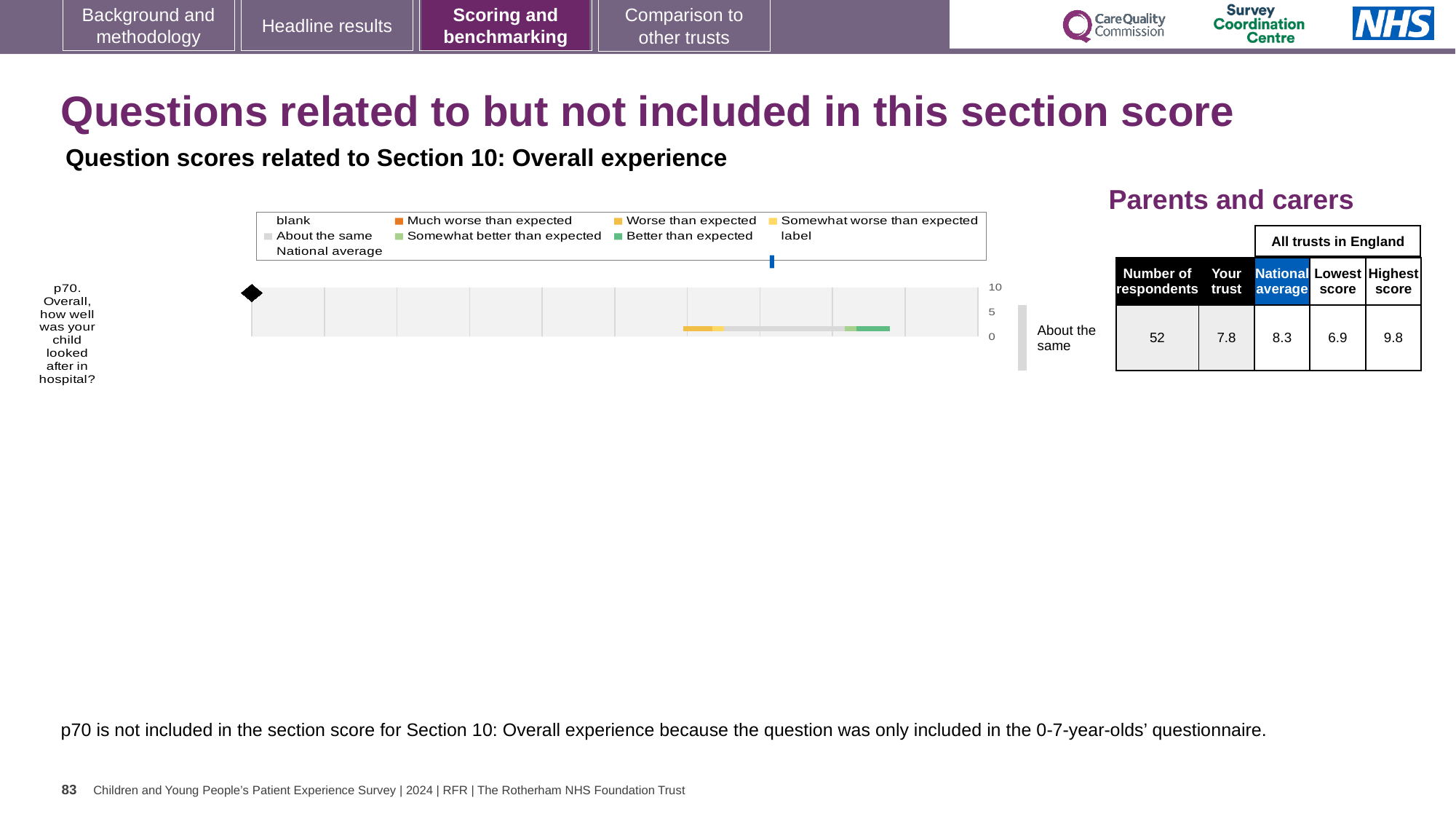
What is the national average score for p70 shown in the table? 8.3 What is the 'Your trust' score for p70 shown in the table? 7.8 How many respondents answered p70 for this trust? 52 What is the difference between the highest and lowest scores among all trusts in England for p70? 2.9 According to the label next to the chart, how does the trust's result for p70 compare with what was expected? About the same What is the difference between the national average and the 'Your trust' score for p70? 0.5 What kind of chart is used to show the p70 question score on this slide? bar chart What is the highest score among all trusts in England for p70? 9.8 Which question is plotted in the chart on this slide? p70. Overall, how well was your child looked after in hospital? What is the lowest score among all trusts in England for p70? 6.9 How many questions are plotted in the chart on this slide? 1 Which is larger for p70: the 'Your trust' score or the national average? National average